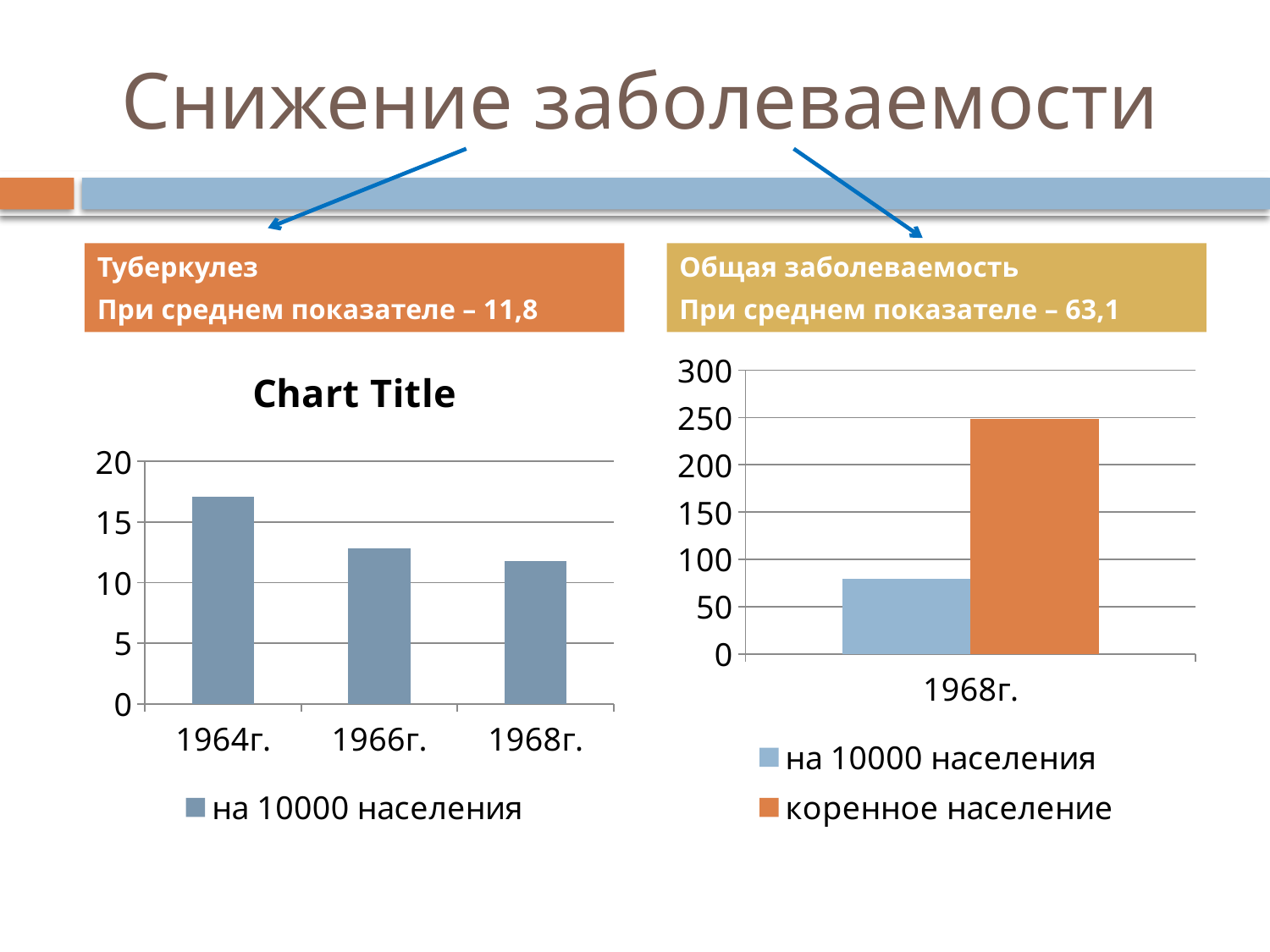
In the left chart titled "Chart Title", is the value for 1968г. greater or less than 15? less In the left chart titled "Chart Title", which year has the lowest value? 1968г. How many series does the legend of the right chart list? 2 How many categories are shown on the x axis of the left chart titled "Chart Title"? 3 In the left chart titled "Chart Title", which year has the highest value? 1964г. In the left chart titled "Chart Title", is the value for 1964г. greater or less than 15? greater In the right chart, is the value for "коренное население" greater or less than 200? greater In the left chart titled "Chart Title", do the values rise or fall from 1964г. to 1968г.? fall In the right chart, which series has the larger value for 1968г.: "на 10000 населения" or "коренное население"? коренное население What kind of chart is the left chart titled "Chart Title"? bar chart What series name does the legend of the left chart titled "Chart Title" show? на 10000 населения